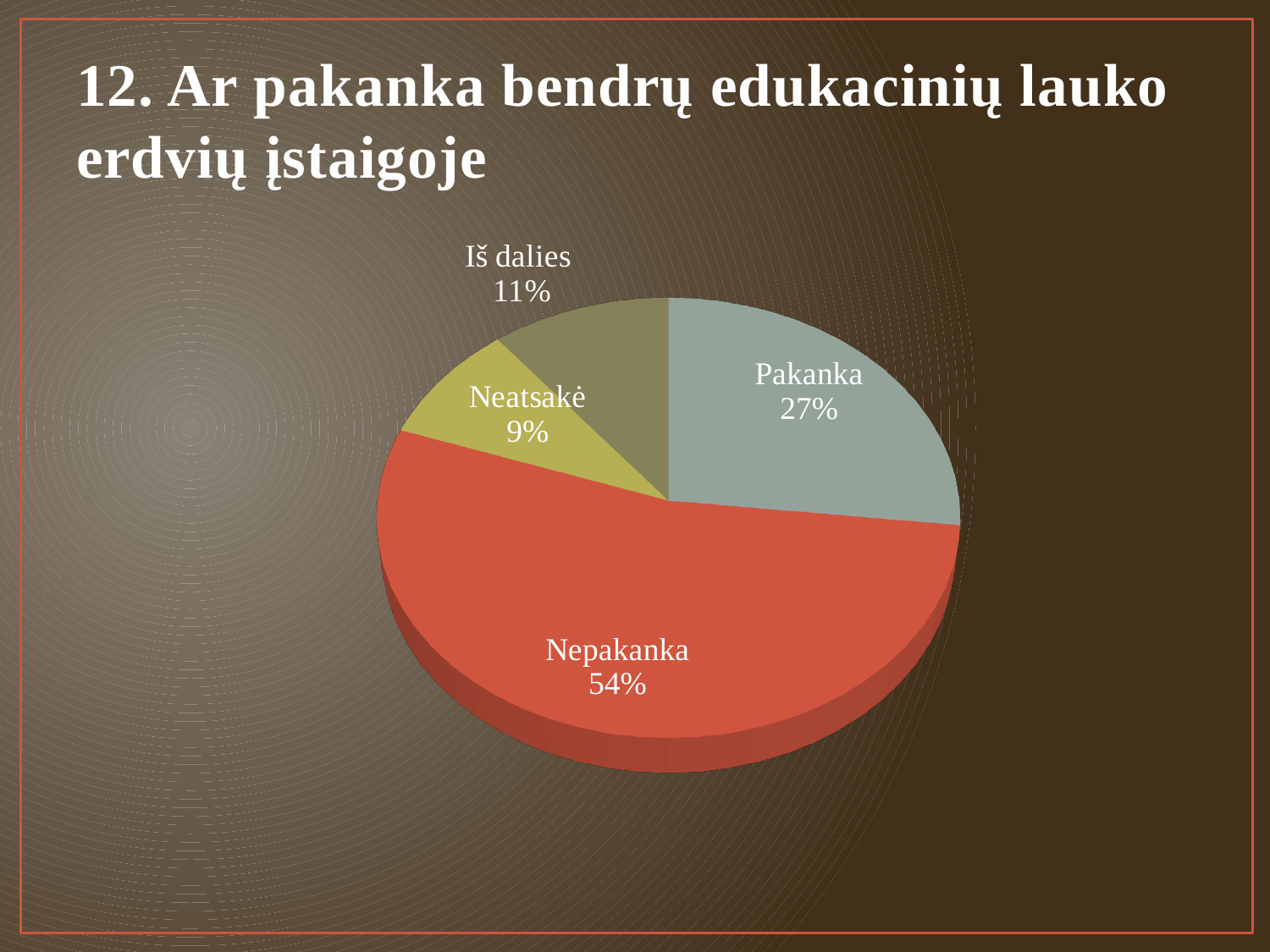
What share of the pie does Nepakanka have? 54% Which is larger, Iš dalies or Neatsakė? Iš dalies How many slices does the pie chart have? 4 What kind of chart is shown on the slide? pie chart What colour is the Nepakanka slice? red What is the difference in percentage points between Pakanka and Iš dalies? 16 Which slice of the pie is the smallest? Neatsakė Which slice of the pie is the largest? Nepakanka What is the difference in percentage points between Nepakanka and Pakanka? 27 What share of the pie does Pakanka have? 27% What share of the pie does Neatsakė have? 9%